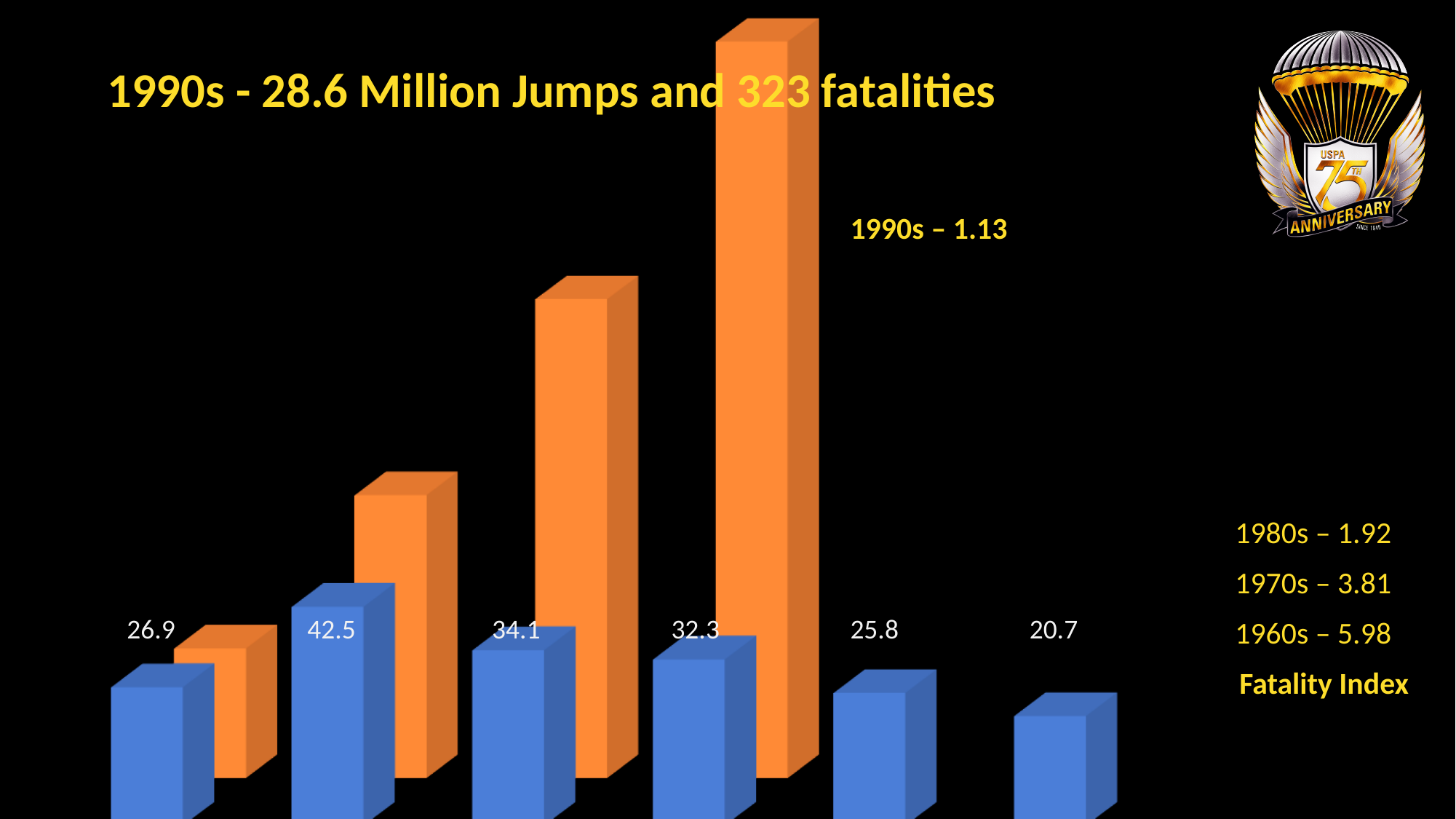
What kind of chart is shown on the slide? Bar chart How many blue bars are shown in the chart? 6 What is the value shown on the second blue bar from the left? 42.5 Do the blue bar values rise or fall from the second bar to the sixth bar? Fall How many orange bars are shown in the chart? 4 What is the value shown on the last blue bar on the right? 20.7 Which is larger, the third blue bar (34.1) or the fourth blue bar (32.3)? The third blue bar (34.1) Which blue bar has the highest labelled value? The second bar (42.5) What is the title of the slide? 1990s - 28.6 Million Jumps and 323 fatalities What is the difference between the highest blue bar value (42.5) and the lowest blue bar value (20.7)? 21.8 What is the value shown on the first blue bar from the left? 26.9 Which blue bar has the lowest labelled value? The sixth bar (20.7)